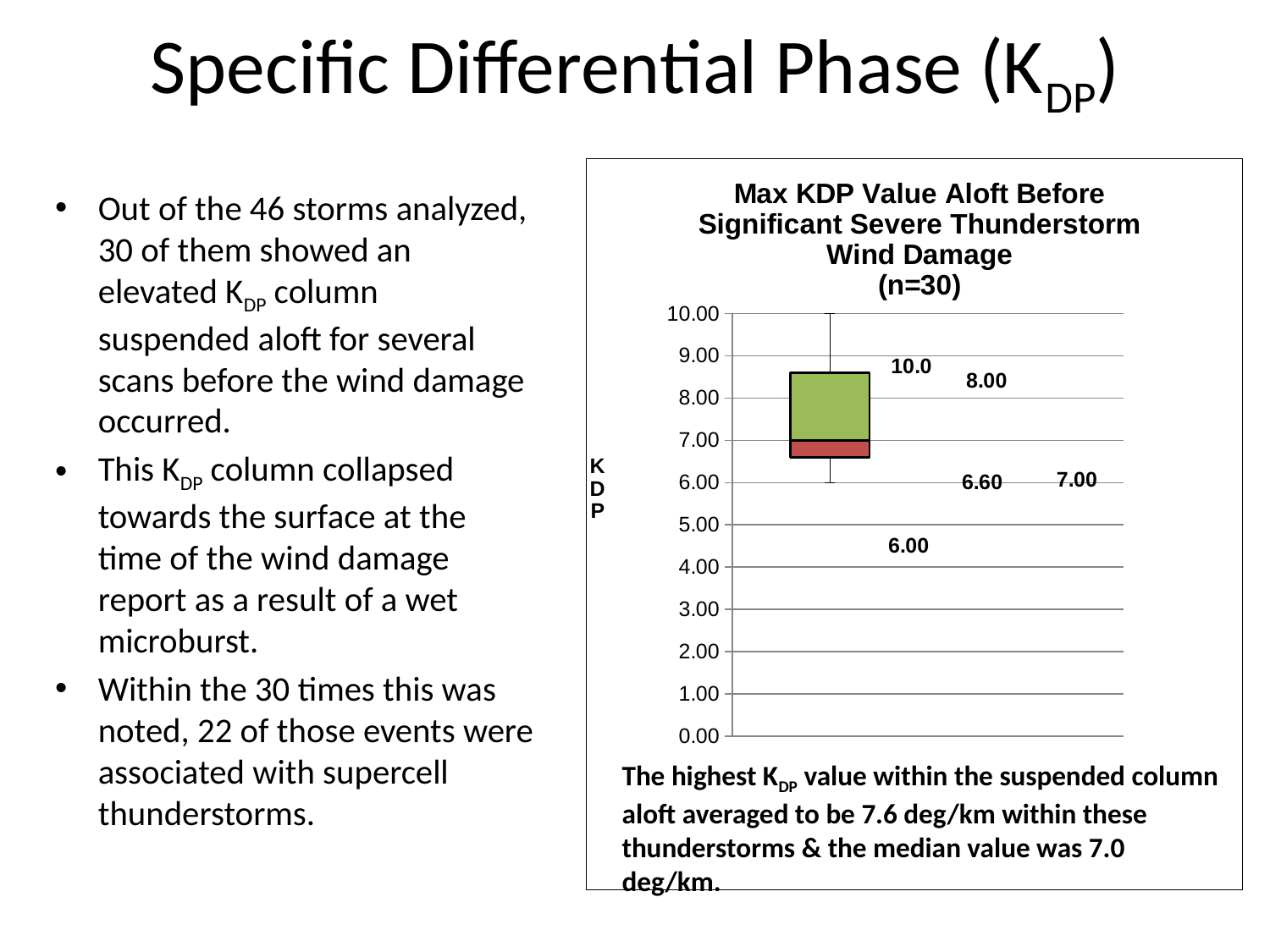
How many data labels are printed on the chart? 5 What is the title of the chart? Max KDP Value Aloft Before Significant Severe Thunderstorm Wind Damage (n=30) What is the highest value labeled on the chart? 10.0 What is the lowest value labeled on the chart? 6.00 What is the maximum tick value shown on the vertical axis? 10.00 Is the bottom of the lower whisker greater or less than 5.00? greater Is the top of the upper whisker greater or less than 9.00? greater What is the difference between the highest labeled value (10.0) and the lowest labeled value (6.00)? 4.0 How many storms (n) does the chart title say are included? 30 What is the label on the vertical axis? KDP What kind of chart is shown on the slide? Box-and-whisker plot Which labeled value is larger, 8.00 or 6.60? 8.00